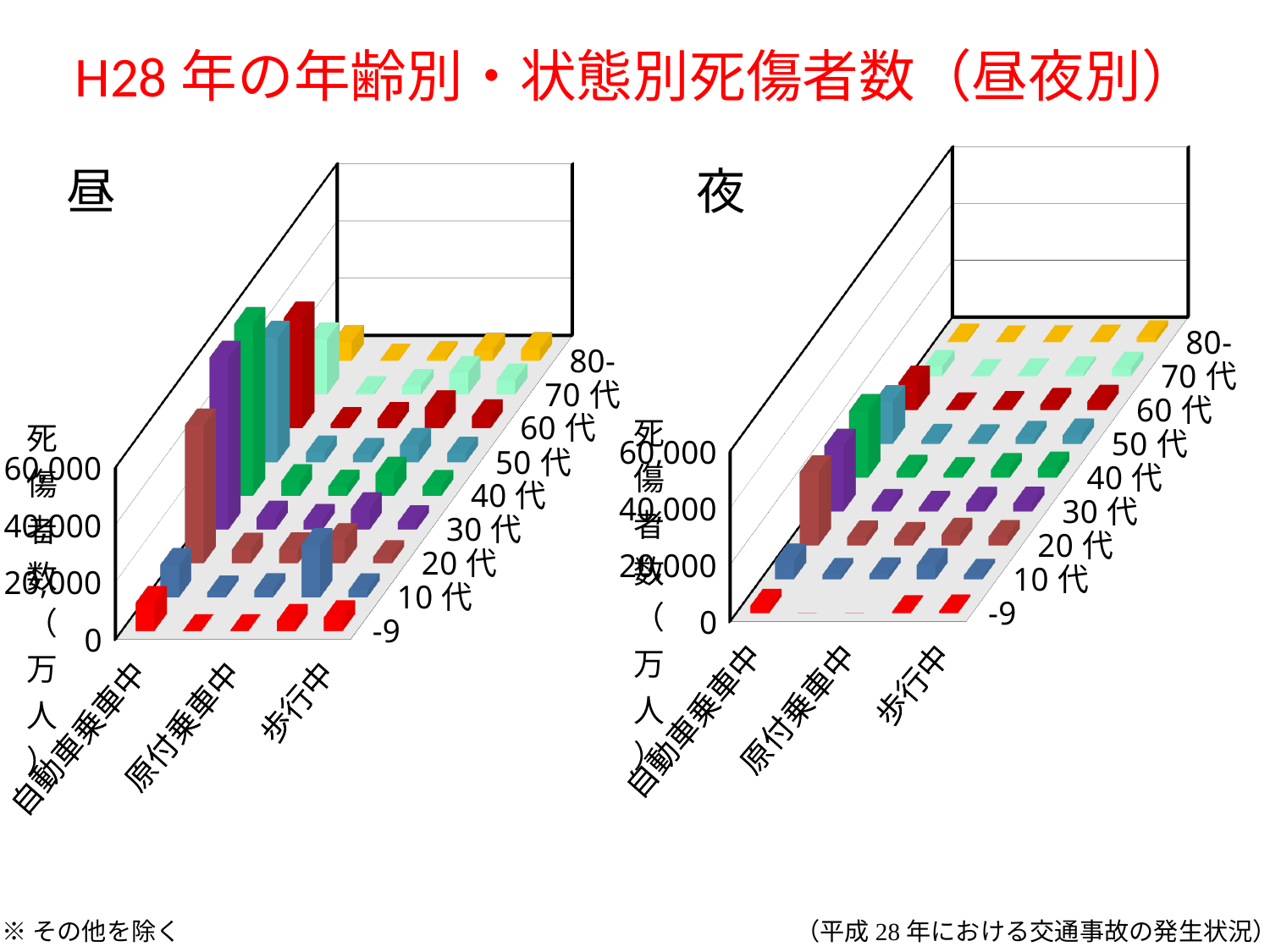
What is the highest tick value shown on the vertical axis of the 昼 chart? 60,000 In the 昼 chart, which 状態 category has the tallest bars overall? 自動車乗車中 In the 昼 chart, which is larger for the 40代 age group: 自動車乗車中 or 原付乗車中? 自動車乗車中 In the 夜 chart, how many age groups are shown along the depth axis? 9 In the 夜 chart, which 状態 category has the tallest bars overall? 自動車乗車中 In the 夜 chart, is the value for 原付乗車中 in the 30代 age group greater or less than 20,000? less What is the title of the slide? H28年の年齢別・状態別死傷者数（昼夜別） In the 夜 chart, which is larger for the 20代 age group: 自動車乗車中 or 歩行中? 自動車乗車中 What kind of chart is the 昼 chart on the left? bar chart What kind of chart is the 夜 chart on the right? bar chart In the 昼 chart, is the value for 歩行中 in the -9 age group greater or less than 20,000? less